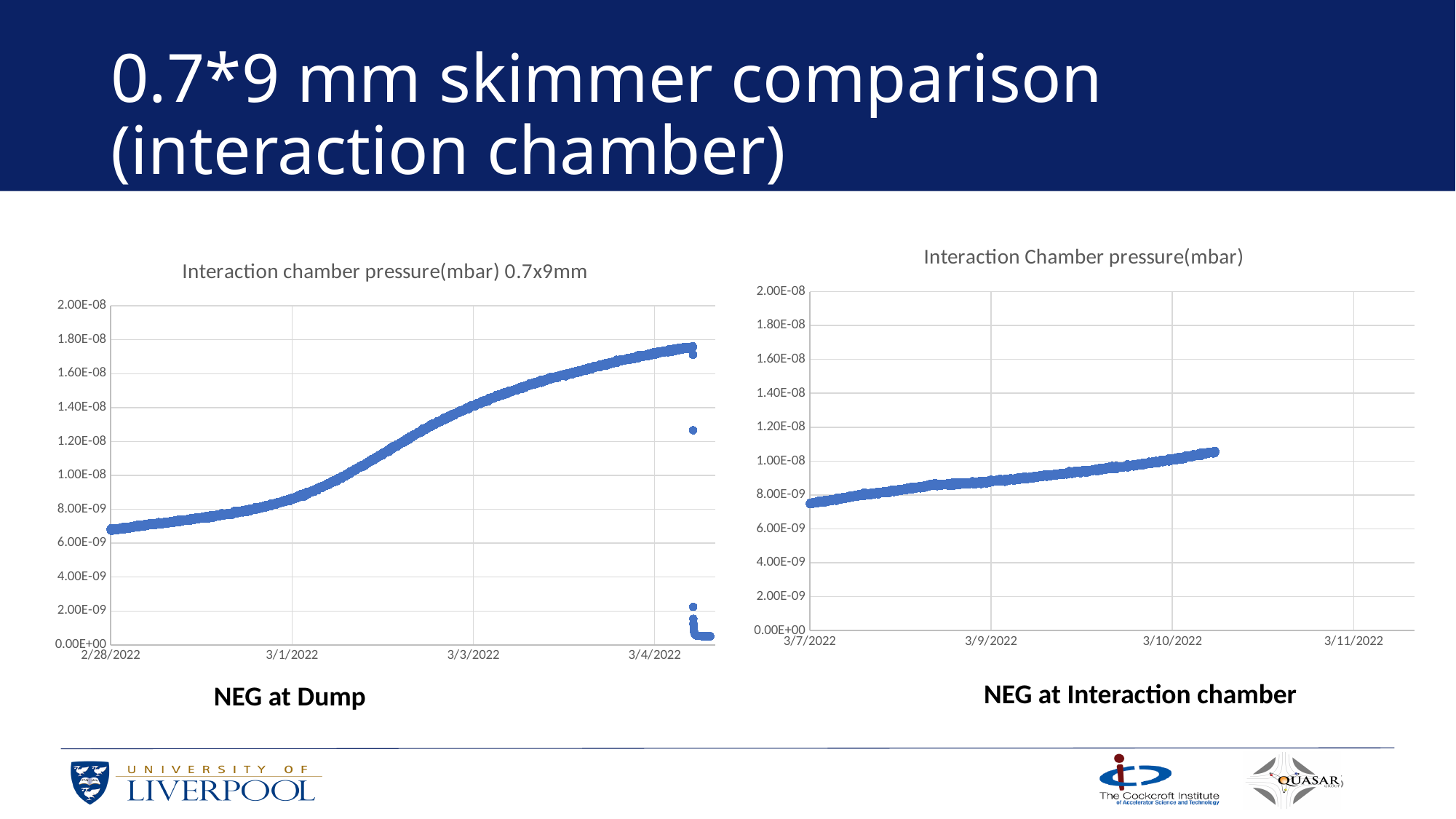
In the left chart (NEG at Dump), does the pressure rise or fall from 2/28/2022 to 3/4/2022? rise In the right chart (NEG at Interaction chamber), is the highest plotted pressure greater or less than 1.20E-08? less What kind of chart is the right chart titled 'Interaction Chamber pressure(mbar)'? scatter chart What is the title of the left chart? Interaction chamber pressure(mbar) 0.7x9mm In the right chart (NEG at Interaction chamber), does the pressure rise or fall from 3/7/2022 to 3/10/2022? rise What is the highest tick value shown on the y axis of the right chart? 2.00E-08 In the left chart (NEG at Dump), is the pressure at 3/4/2022 greater or less than 1.60E-08? greater Which chart reaches a higher peak pressure, the left chart (NEG at Dump) or the right chart (NEG at Interaction chamber)? the left chart (NEG at Dump) In the left chart (NEG at Dump), is the pressure at 2/28/2022 greater or less than 8.00E-09? less What kind of chart is the left chart titled 'Interaction chamber pressure(mbar) 0.7x9mm'? scatter chart How many charts are shown on the slide? 2